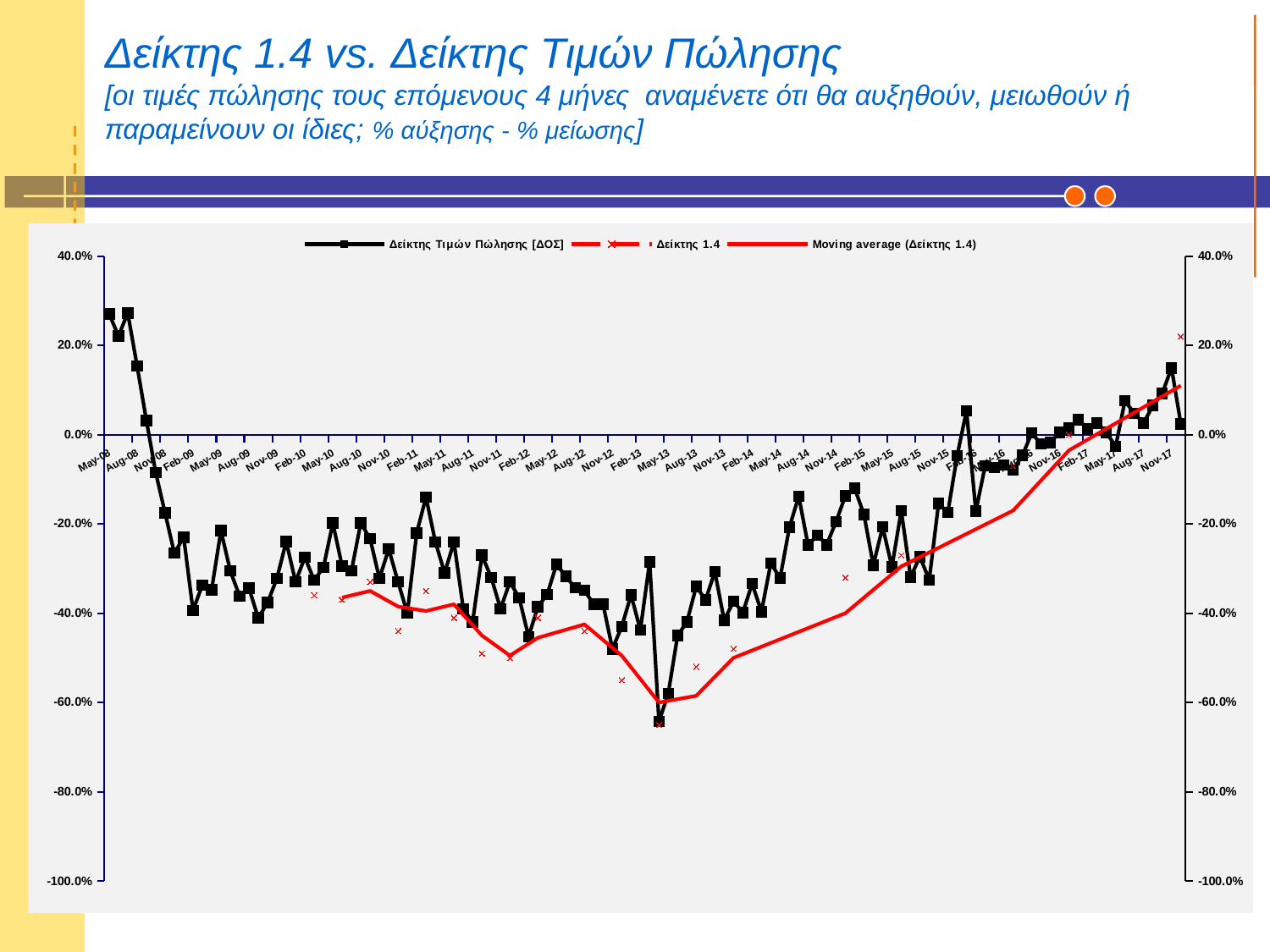
Is the value of Δείκτης Τιμών Πώλησης [ΔΟΣ] at May-13 greater or less than -40.0%? less Is the value of Δείκτης Τιμών Πώλησης [ΔΟΣ] at May-08 greater or less than 20.0%? greater What is the name of the series drawn as a black line with square markers? Δείκτης Τιμών Πώλησης [ΔΟΣ] Does the Moving average (Δείκτης 1.4) line rise or fall between May-13 and Nov-17? rise Is the value of the Moving average (Δείκτης 1.4) line at May-13 greater or less than -40.0%? less How many series does the chart legend list? 3 Does the Δείκτης Τιμών Πώλησης [ΔΟΣ] line rise or fall between May-08 and Feb-09? fall What is the lowest value shown on the vertical axis? -100.0% What kind of chart is shown on the slide? line chart What colour is the 'Moving average (Δείκτης 1.4)' line? red